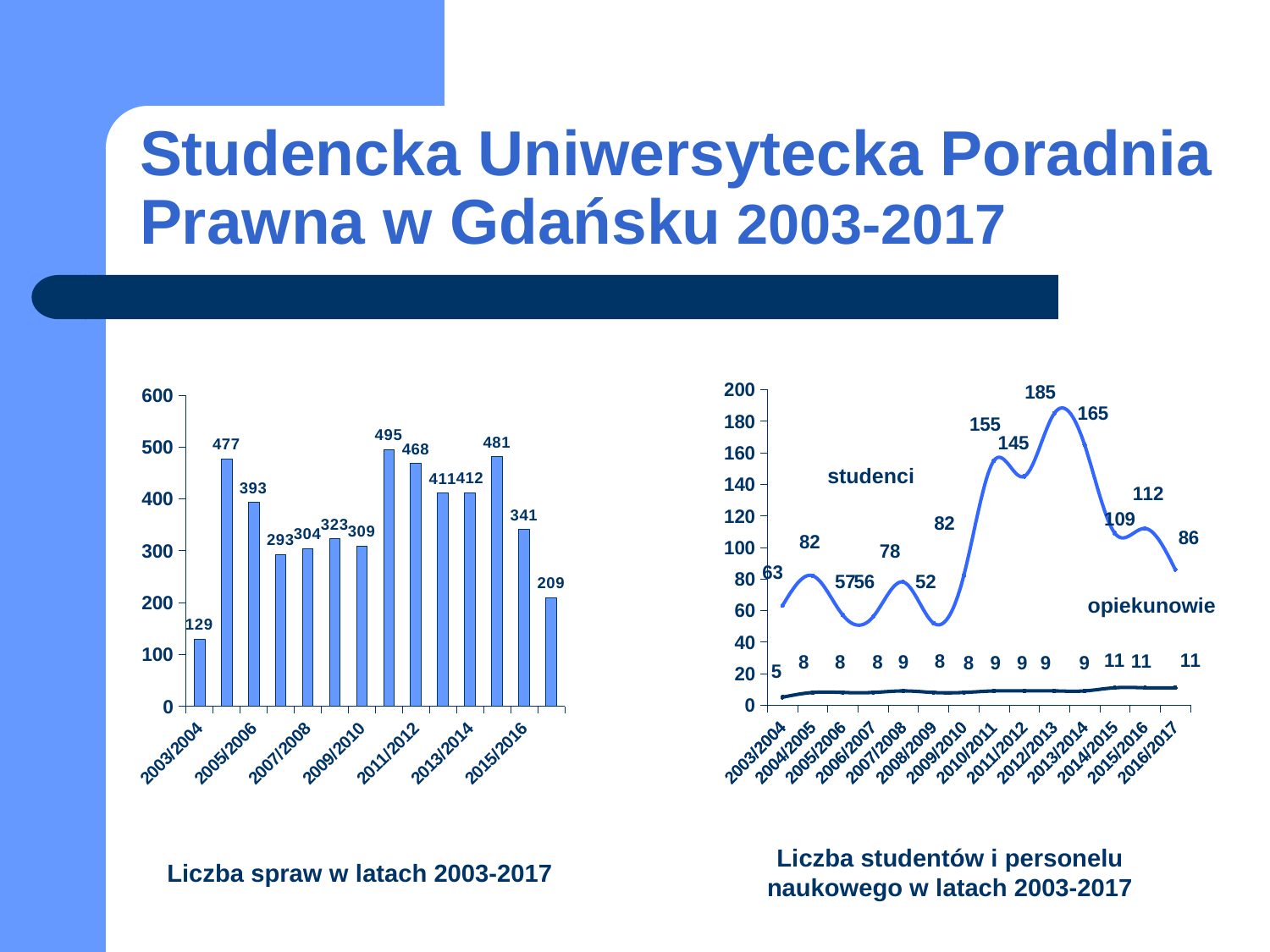
In the chart titled 'Liczba spraw w latach 2003-2017', what is the highest value shown? 495 In the chart titled 'Liczba studentów i personelu naukowego w latach 2003-2017', what is the value for studenci in 2012/2013? 185 In the chart titled 'Liczba spraw w latach 2003-2017', what is the difference between the values for 2005/2006 and 2015/2016? 52 In the chart titled 'Liczba spraw w latach 2003-2017', how many bars are plotted? 14 In the chart titled 'Liczba studentów i personelu naukowego w latach 2003-2017', which year has the lowest value for studenci? 2008/2009 In the chart titled 'Liczba studentów i personelu naukowego w latach 2003-2017', what is the value for opiekunowie in 2003/2004? 5 What kind of chart is the one on the left of the slide? Bar chart In the chart titled 'Liczba studentów i personelu naukowego w latach 2003-2017', what are the names of the two series plotted? studenci and opiekunowie In the chart titled 'Liczba studentów i personelu naukowego w latach 2003-2017', which is larger: studenci in 2010/2011 or studenci in 2016/2017? 2010/2011 In the chart titled 'Liczba spraw w latach 2003-2017', what is the value for 2011/2012? 468 In the chart titled 'Liczba spraw w latach 2003-2017', what is the value for 2003/2004? 129 In the chart titled 'Liczba spraw w latach 2003-2017', which year has the lowest value? 2003/2004